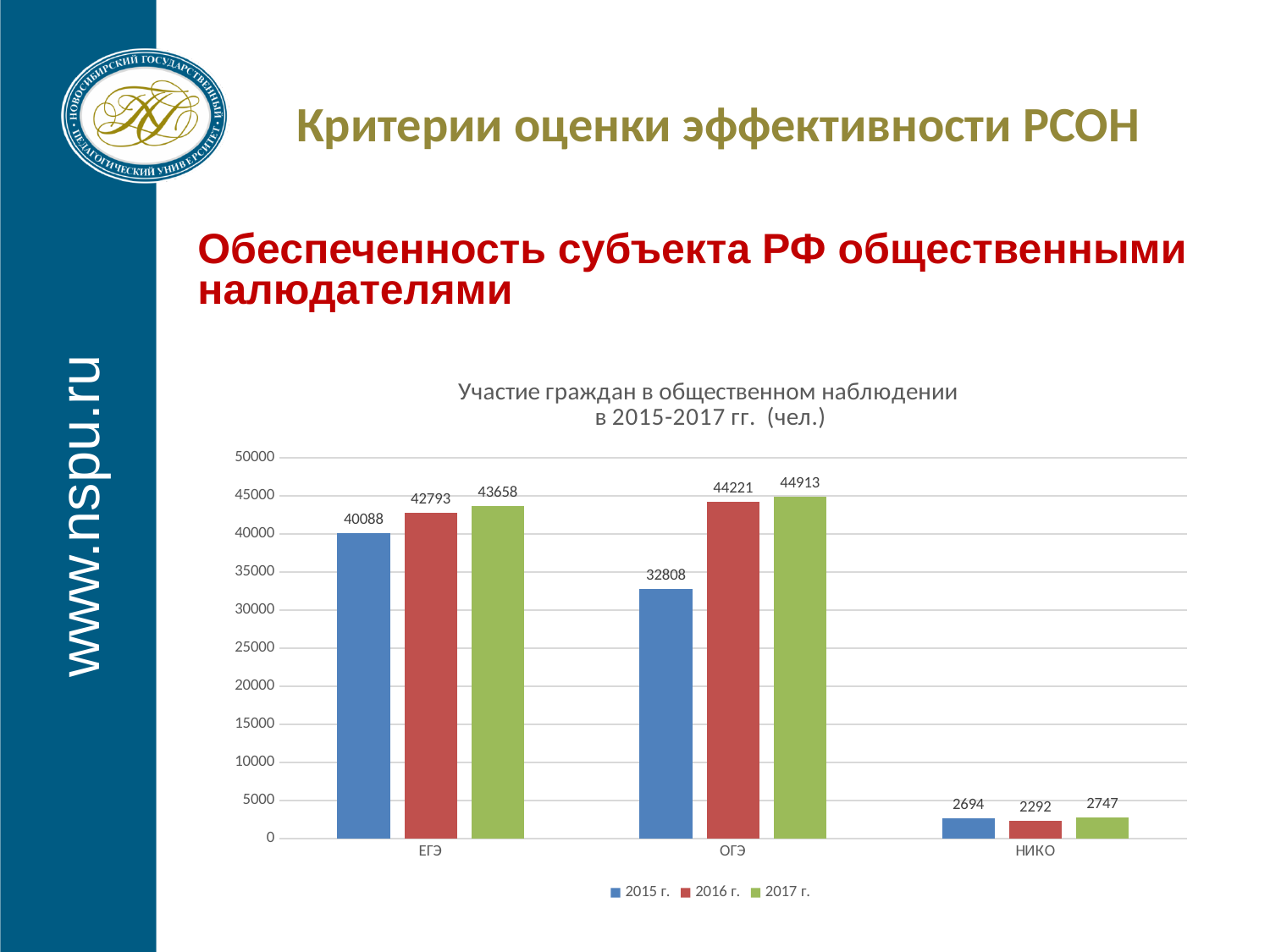
Which category has the highest value in 2017 г.? ОГЭ What is the value for НИКО in 2016 г.? 2292 Which category has the lowest value in 2015 г.? НИКО Which is larger for ЕГЭ: the 2016 г. value or the 2017 г. value? 2017 г. What is the title of the chart? Участие граждан в общественном наблюдении в 2015-2017 гг. (чел.) Is the value for ОГЭ in 2015 г. greater or less than 35000? less What kind of chart is shown? bar chart What is the value for ОГЭ in 2017 г.? 44913 How many series does the legend list? 3 How many categories are shown on the x axis? 3 What is the value for ЕГЭ in 2015 г.? 40088 What is the difference between the 2016 г. and 2015 г. values for ОГЭ? 11413